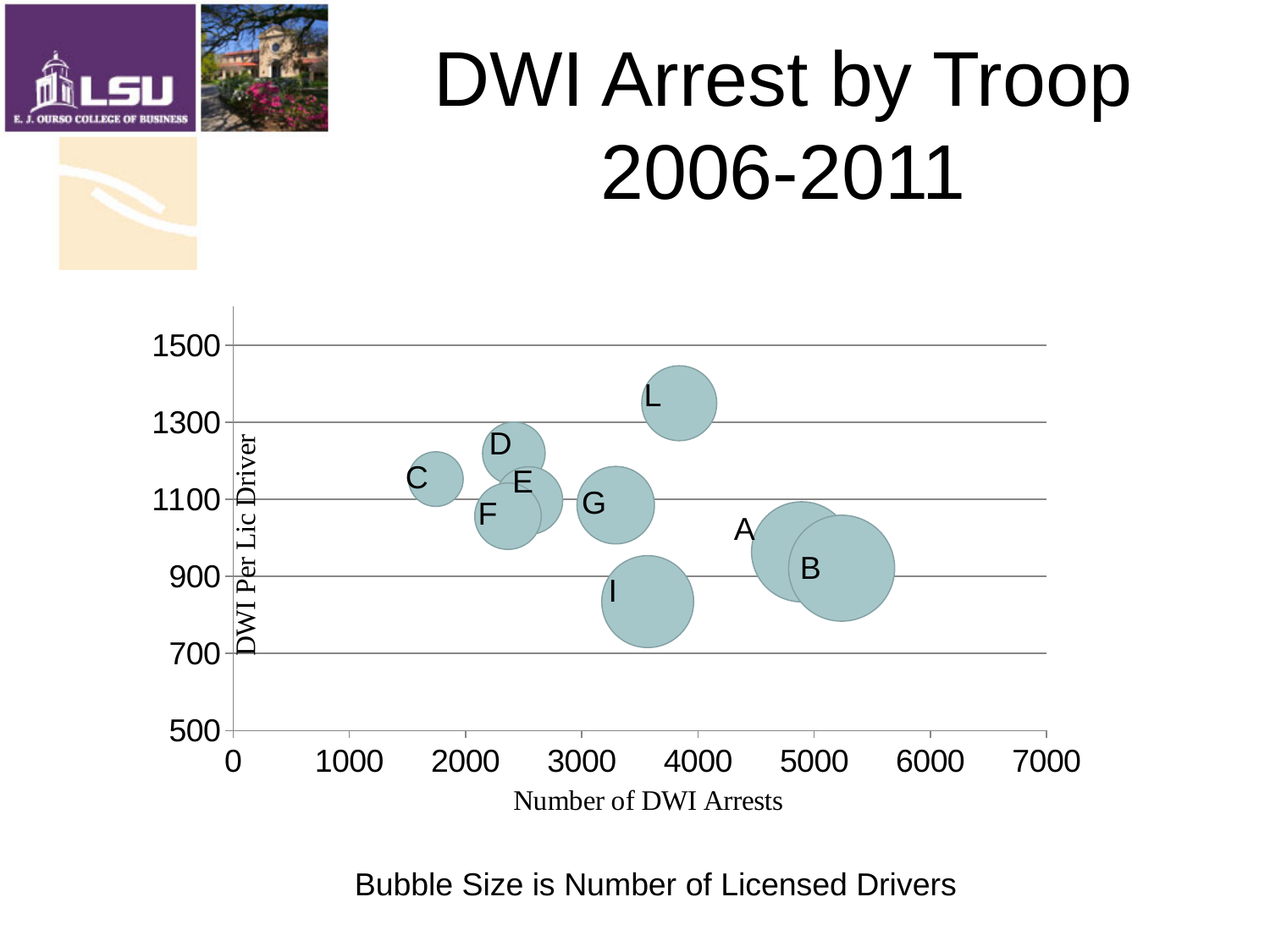
Is the Number of DWI Arrests for troop B greater or less than 5000? greater Which troop has more DWI arrests, troop A or troop C? A Which troop has the lowest Number of DWI Arrests? C According to the slide, what does the bubble size represent? Number of Licensed Drivers Is the Number of DWI Arrests for troop C greater or less than 2000? less Which troop has the highest Number of DWI Arrests? B How many troops are plotted as bubbles on the chart? 9 What kind of chart is shown on the slide? Bubble chart Is the DWI Per Lic Driver value for troop I greater or less than 900? less Which troop has the lowest DWI Per Lic Driver value? I Which troop has the highest DWI Per Lic Driver value? L